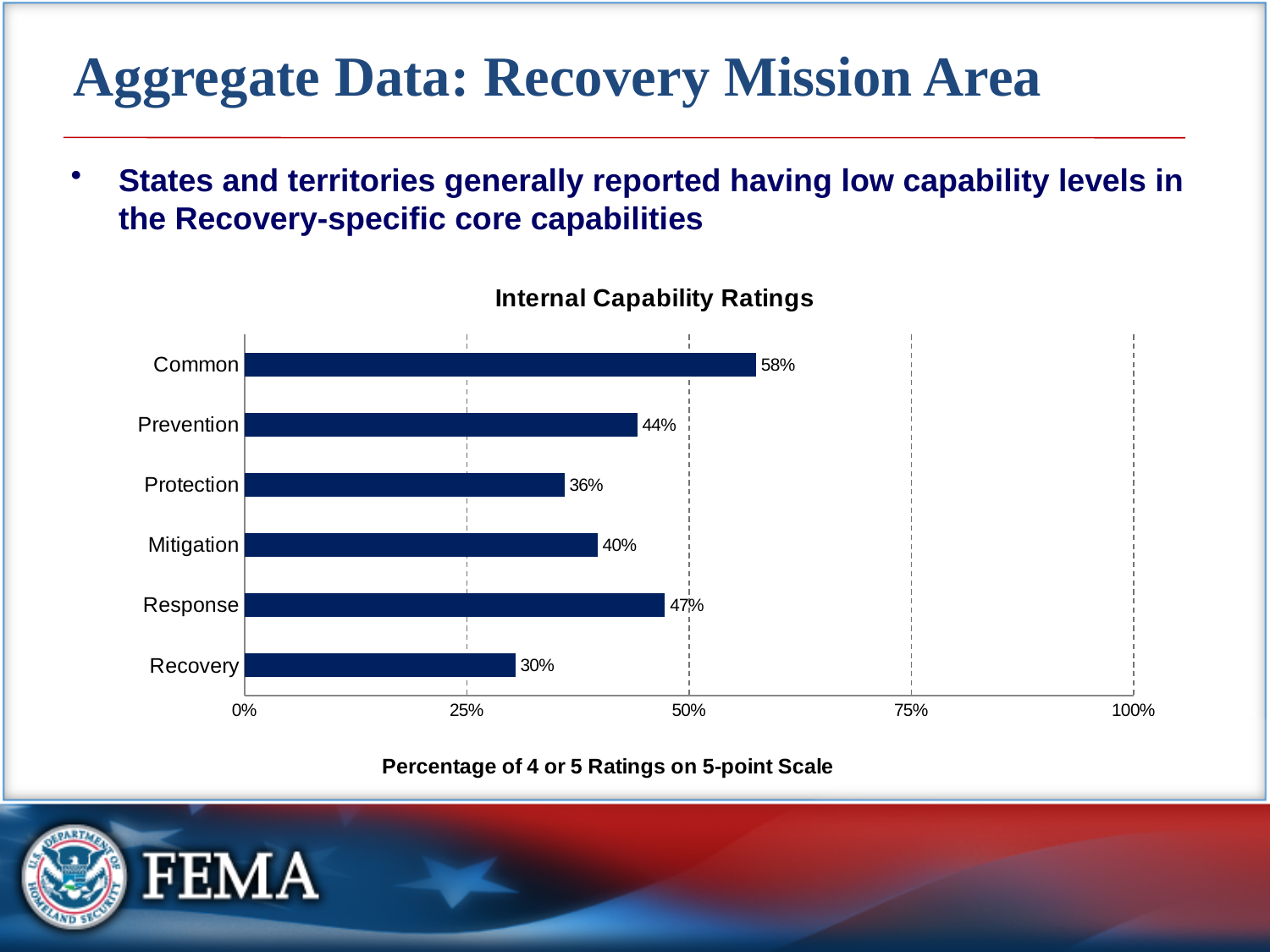
What is the difference between the Common and Recovery values in the Internal Capability Ratings chart? 28% What is the difference between the Response and Prevention values in the Internal Capability Ratings chart? 3% What is the x-axis label of the Internal Capability Ratings chart? Percentage of 4 or 5 Ratings on 5-point Scale What is the value for Mitigation in the Internal Capability Ratings chart? 40% Which mission area has the lowest Internal Capability Rating? Recovery Which has a higher Internal Capability Rating, Protection or Mitigation? Mitigation Which mission area has the highest Internal Capability Rating? Common How many mission areas are shown in the Internal Capability Ratings chart? 6 What is the value for Recovery in the Internal Capability Ratings chart? 30% Is the value for Response greater or less than 50%? less What kind of chart is the Internal Capability Ratings chart? bar chart What is the value for Common in the Internal Capability Ratings chart? 58%